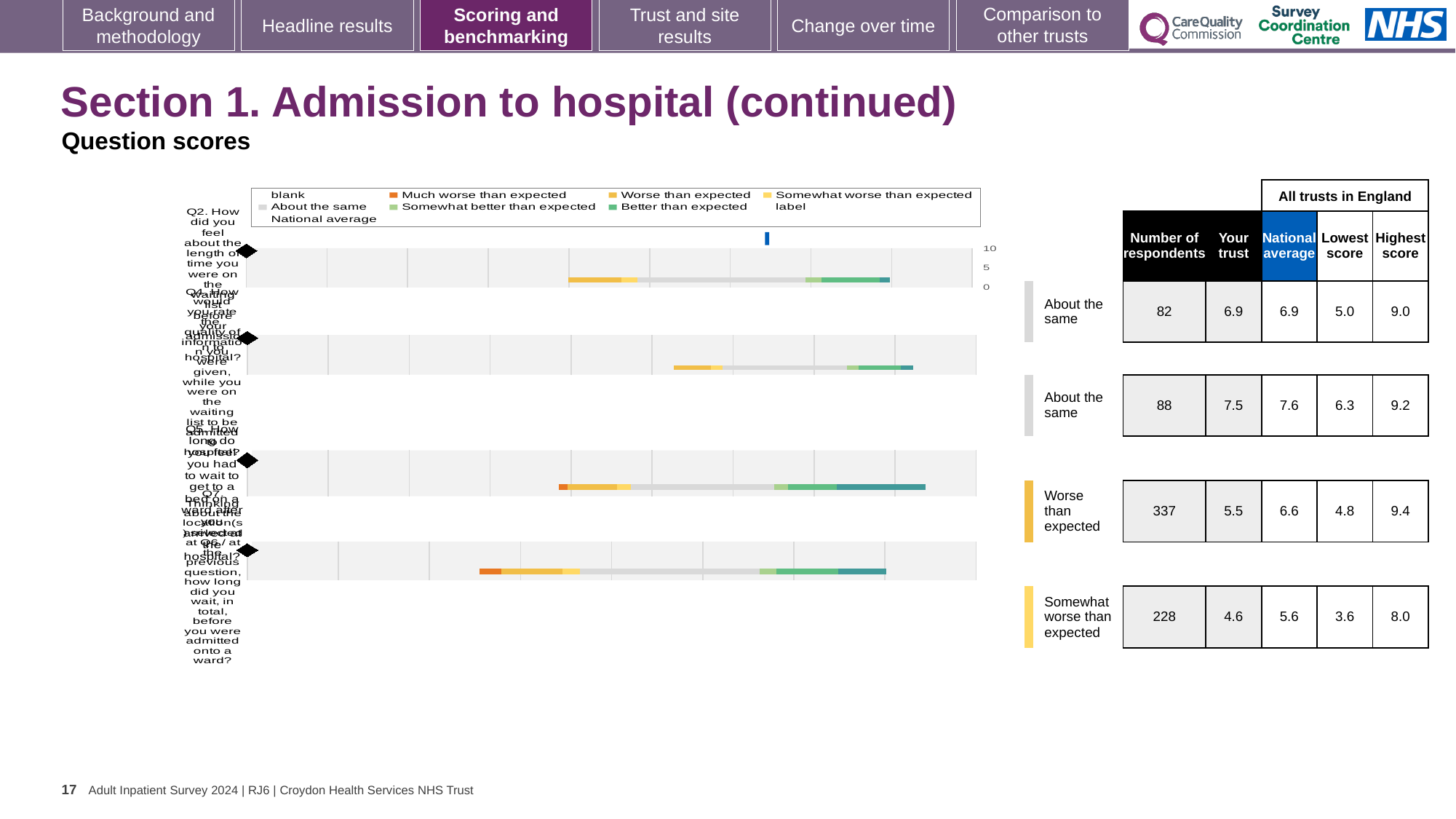
Which table row has the largest number of respondents? the third row (Worse than expected), 337 Which table row has the lowest 'Your trust' score? the fourth row (Somewhat worse than expected), 4.6 In the table, what is the number of respondents for the first row (rated 'About the same')? 82 What is the difference between the highest score and the lowest score in the fourth row (Somewhat worse than expected)? 4.4 In the table, what is the national average for the fourth row (rated 'Somewhat worse than expected')? 5.6 In the table, what is the 'Your trust' score for the third row (rated 'Worse than expected')? 5.5 In the table, what is the highest score for the second row (rated 'About the same')? 9.2 What is the heading above the 'National average', 'Lowest score' and 'Highest score' columns of the table? All trusts in England Is the 'Your trust' score in the second row larger or smaller than the national average in that row? smaller What kind of chart is shown on the left of the slide? bar chart What is the difference between the national average and the 'Your trust' score in the third row (Worse than expected)? 1.1 How many question bars are plotted in the chart? 4